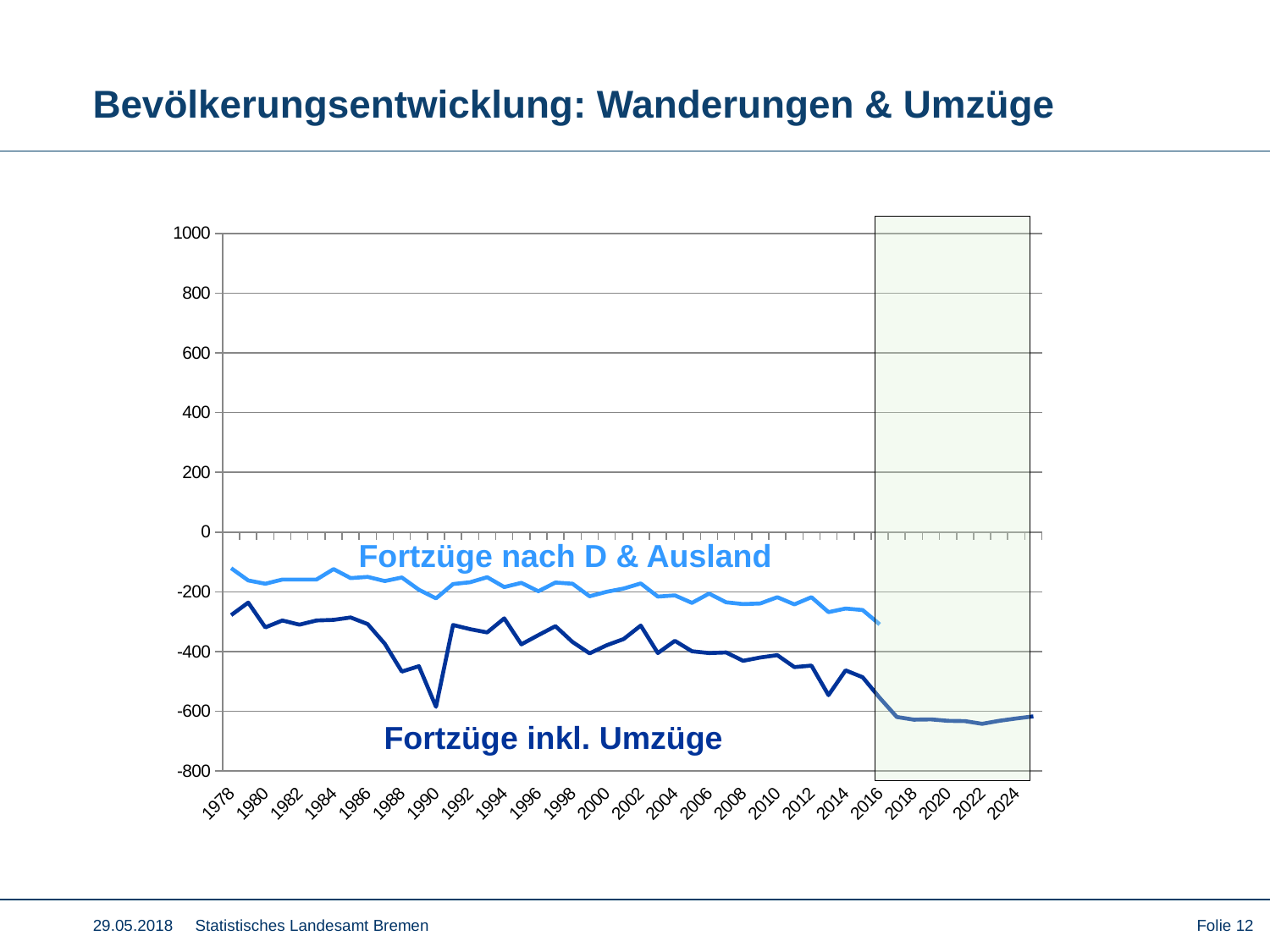
Is the value for Fortzüge inkl. Umzüge in 1978 greater or less than -400? greater What is the highest value shown on the vertical axis? 1000 Is the value for Fortzüge nach D & Ausland in 1978 greater or less than -200? greater How many data series are plotted in the chart? 2 What kind of chart is shown on the slide? line chart Which series is drawn in the darker blue line? Fortzüge inkl. Umzüge Is the value for Fortzüge inkl. Umzüge in 2024 greater or less than -400? less In 2000, which series has the higher value, Fortzüge nach D & Ausland or Fortzüge inkl. Umzüge? Fortzüge nach D & Ausland Does the Fortzüge inkl. Umzüge line overall rise or fall from 1978 to 2024? fall What is the title of the slide containing the chart? Bevölkerungsentwicklung: Wanderungen & Umzüge